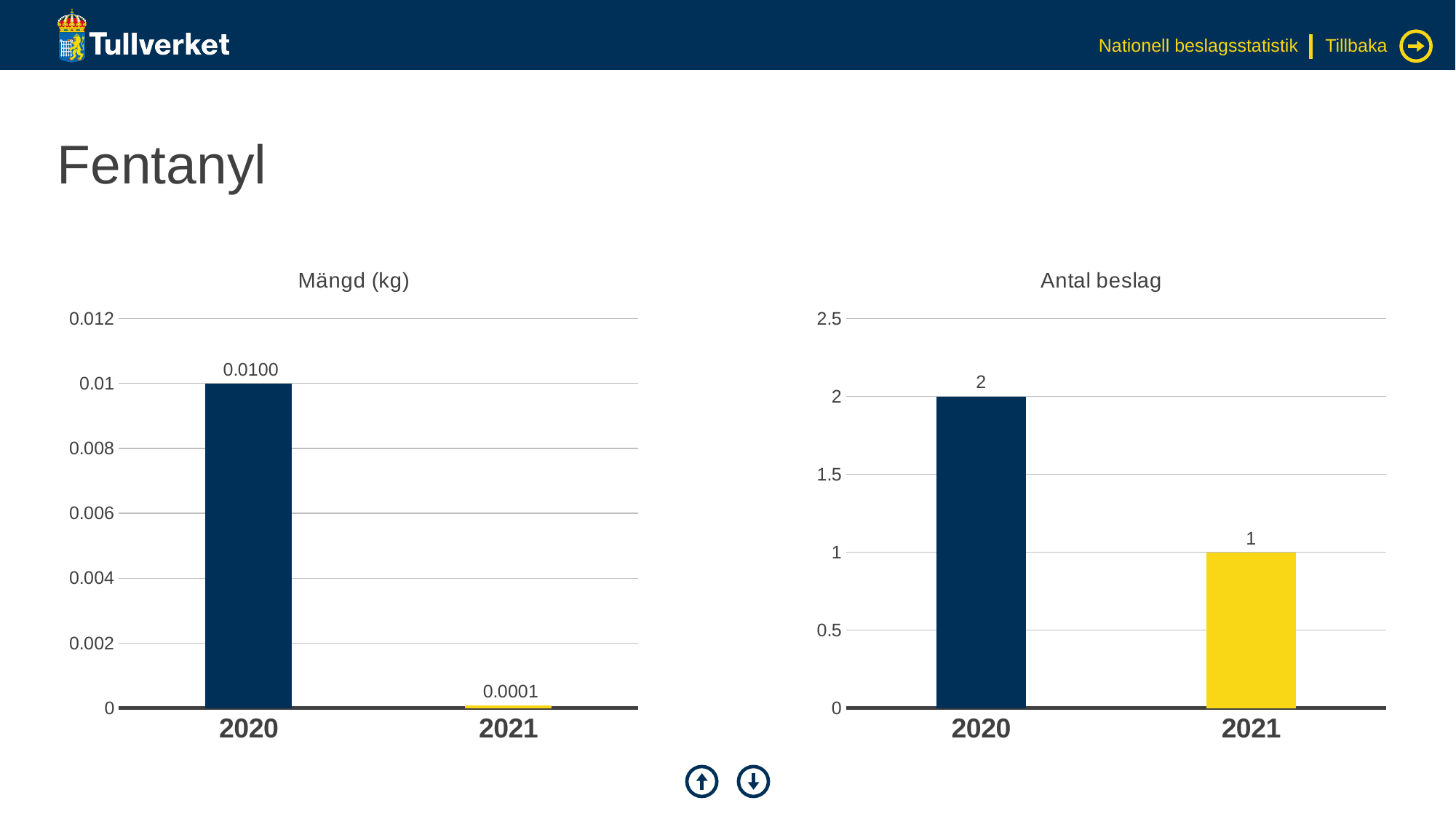
In the 'Antal beslag' chart, what is the difference between the values for 2020 and 2021? 1 In the 'Antal beslag' chart, which year has the highest value? 2020 In the 'Mängd (kg)' chart, which is larger, the value for 2020 or the value for 2021? 2020 In the 'Antal beslag' chart, is the value for 2020 greater or less than 1.5? greater How many categories are shown on the x axis of the 'Mängd (kg)' chart? 2 In the 'Antal beslag' chart, what is the value for 2021? 1 In the 'Mängd (kg)' chart, what is the value for 2020? 0.0100 In the 'Antal beslag' chart, what is the value for 2020? 2 In the 'Mängd (kg)' chart, what is the value for 2021? 0.0001 In the 'Antal beslag' chart, do the values rise or fall from 2020 to 2021? fall What kind of chart is the 'Antal beslag' chart? bar chart In the 'Mängd (kg)' chart, which year has the lowest value? 2021